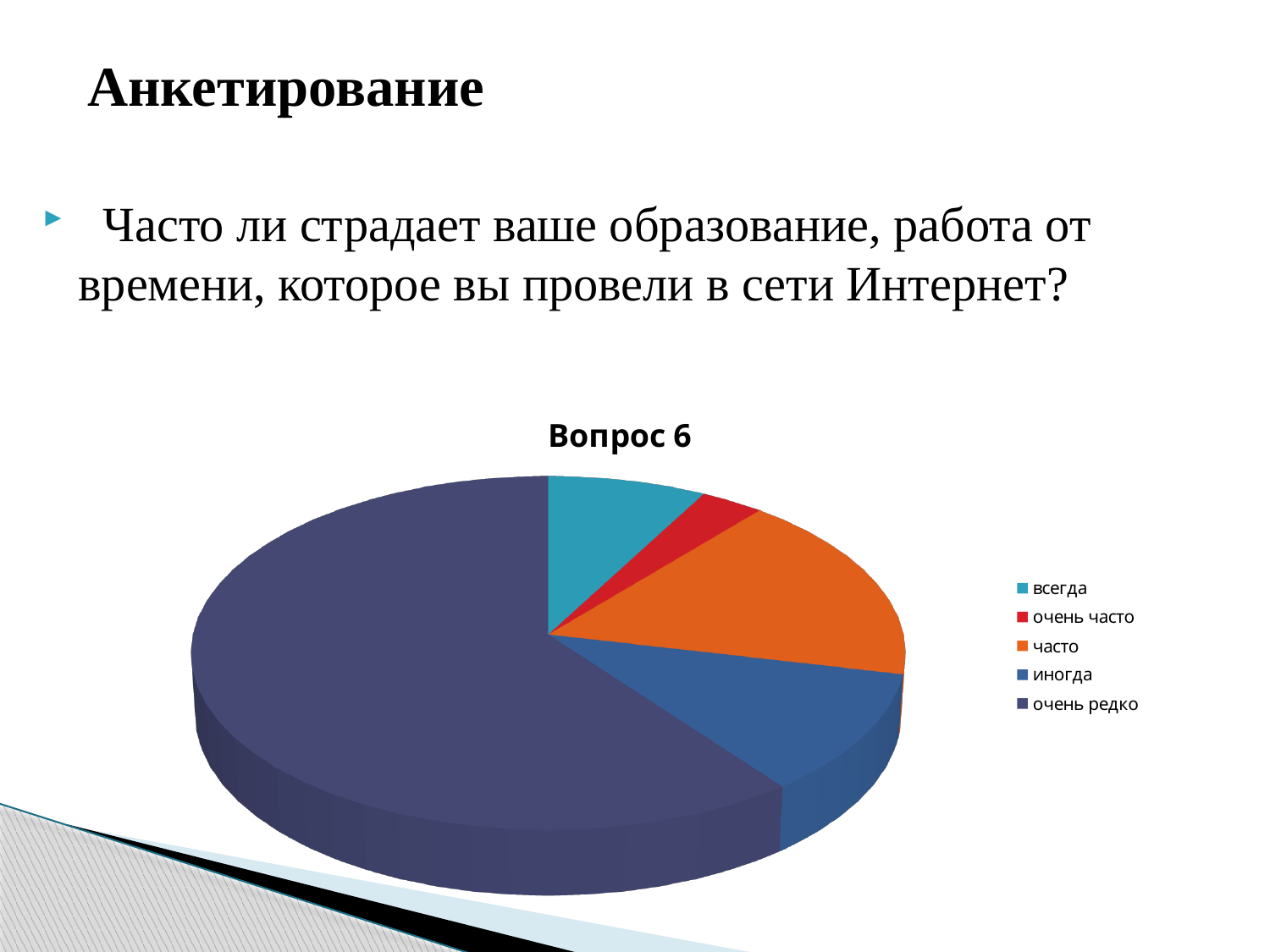
How many entries does the legend list? 5 What is the title of the chart? Вопрос 6 How many categories does the pie chart have? 5 Which slice is larger, часто or очень часто? часто What kind of chart is shown on the slide? pie chart Which slice is larger, очень редко or иногда? очень редко Which slice is larger, всегда or очень часто? всегда Which legend entry is shown in orange? часто Which category has the largest slice of the pie? очень редко Which category has the smallest slice of the pie? очень часто